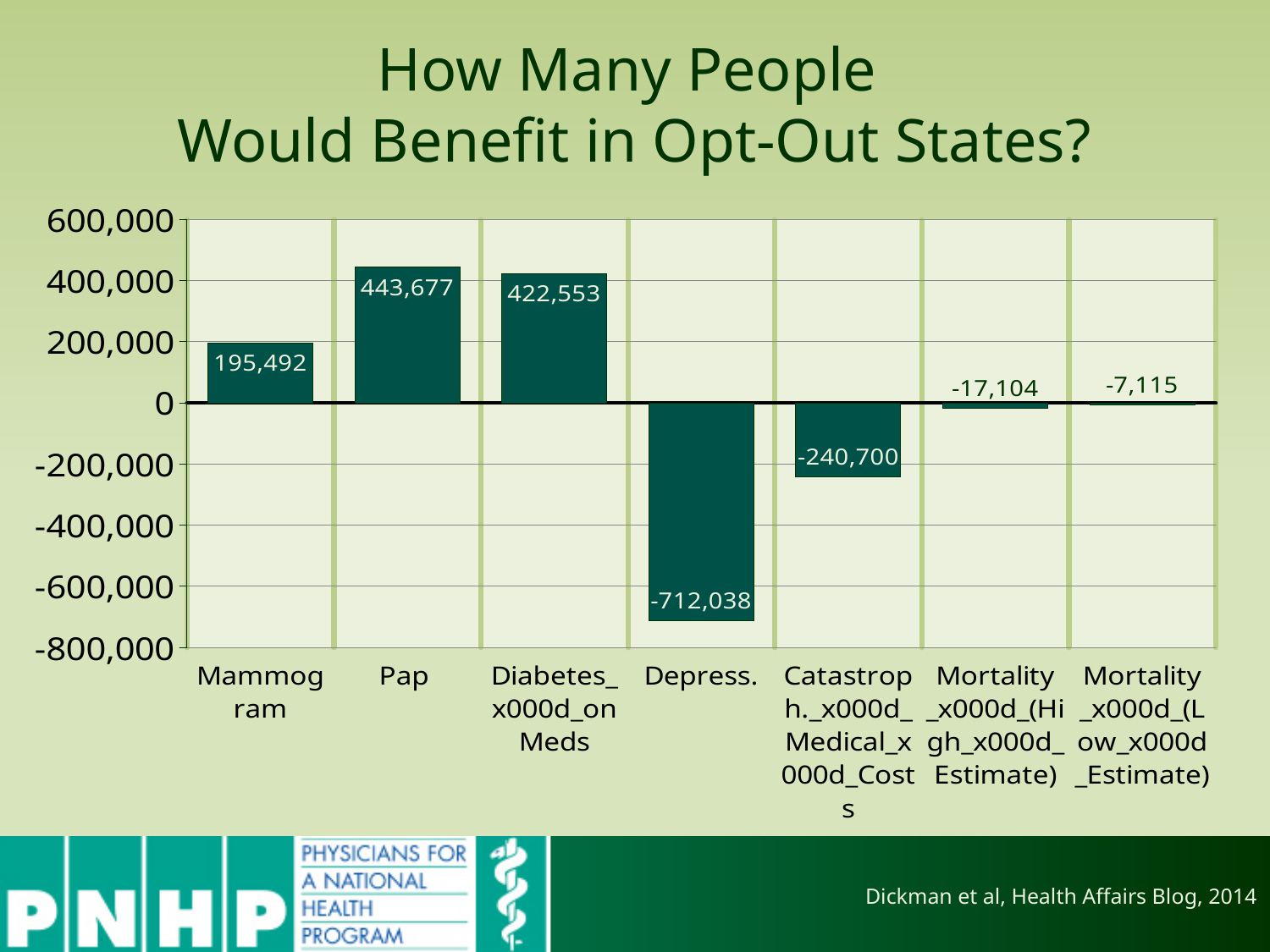
What is the value for Mortality (Low Estimate)? -7,115 What is the value for Depress.? -712,038 Which category has the lowest value? Depress. Which category has the highest value? Pap Which is larger, the value for Mammogram or the value for Diabetes on Meds? Diabetes on Meds Is the value for Catastrophic Medical Costs greater or less than -200,000? less What is the value for Pap? 443,677 What is the title of the chart? How Many People Would Benefit in Opt-Out States? How many categories are shown on the chart? 7 What kind of chart is shown on the slide? bar chart What is the difference between the values for Pap and Diabetes on Meds? 21,124 What is the value for Mammogram? 195,492